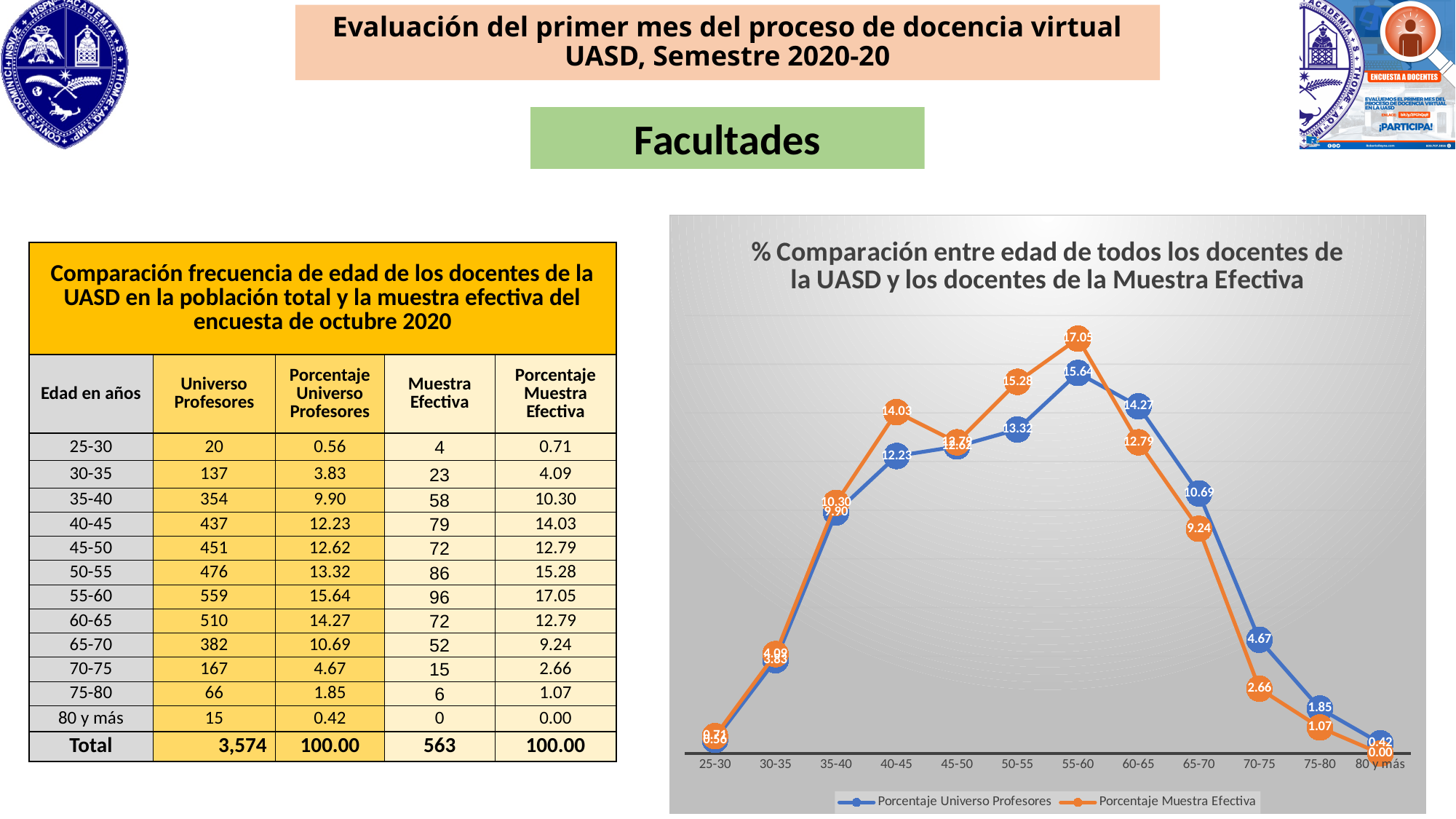
Do the values of Porcentaje Universo Profesores rise or fall from the 60-65 age group to the 80 y más age group? fall Which age group has the lowest value for Porcentaje Muestra Efectiva? 80 y más How many age categories are plotted along the x axis of the chart? 12 Which age group has the highest value for Porcentaje Universo Profesores? 55-60 Which colour is used for the Porcentaje Muestra Efectiva series in the chart? orange How many series does the chart legend list? 2 What is the value of Porcentaje Muestra Efectiva for the 55-60 age group? 17.05 For the 65-70 age group, which series has the larger value: Porcentaje Universo Profesores or Porcentaje Muestra Efectiva? Porcentaje Universo Profesores What kind of chart is shown on the slide? line chart What is the value of Porcentaje Universo Profesores for the 60-65 age group? 14.27 What is the difference between Porcentaje Muestra Efectiva and Porcentaje Universo Profesores for the 55-60 age group? 1.41 What is the value of Porcentaje Muestra Efectiva for the 70-75 age group? 2.66